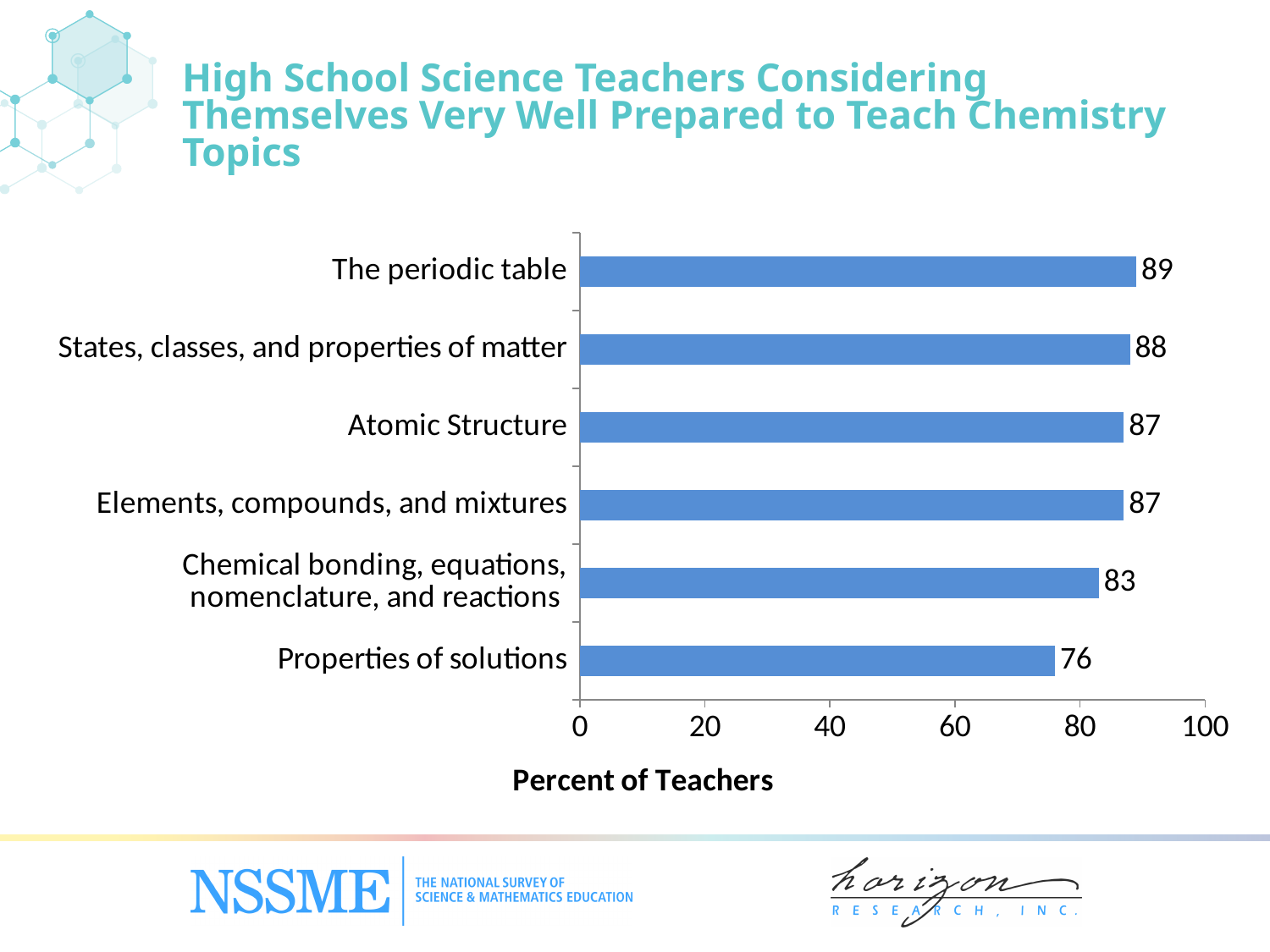
What is the value for States, classes, and properties of matter? 88 Which is larger, the value for Atomic Structure or the value for Properties of solutions? Atomic Structure What is the difference between the values for The periodic table and Properties of solutions? 13 What is the difference between the values for Atomic Structure and Chemical bonding, equations, nomenclature, and reactions? 4 What is the value for Properties of solutions? 76 How many topics are shown in the chart? 6 What kind of chart is shown on the slide? Bar chart What is the value for Chemical bonding, equations, nomenclature, and reactions? 83 What is the label of the horizontal axis? Percent of Teachers Which topic has the highest percent of teachers? The periodic table What percent of teachers consider themselves very well prepared to teach the periodic table? 89 Which topic has the lowest percent of teachers? Properties of solutions